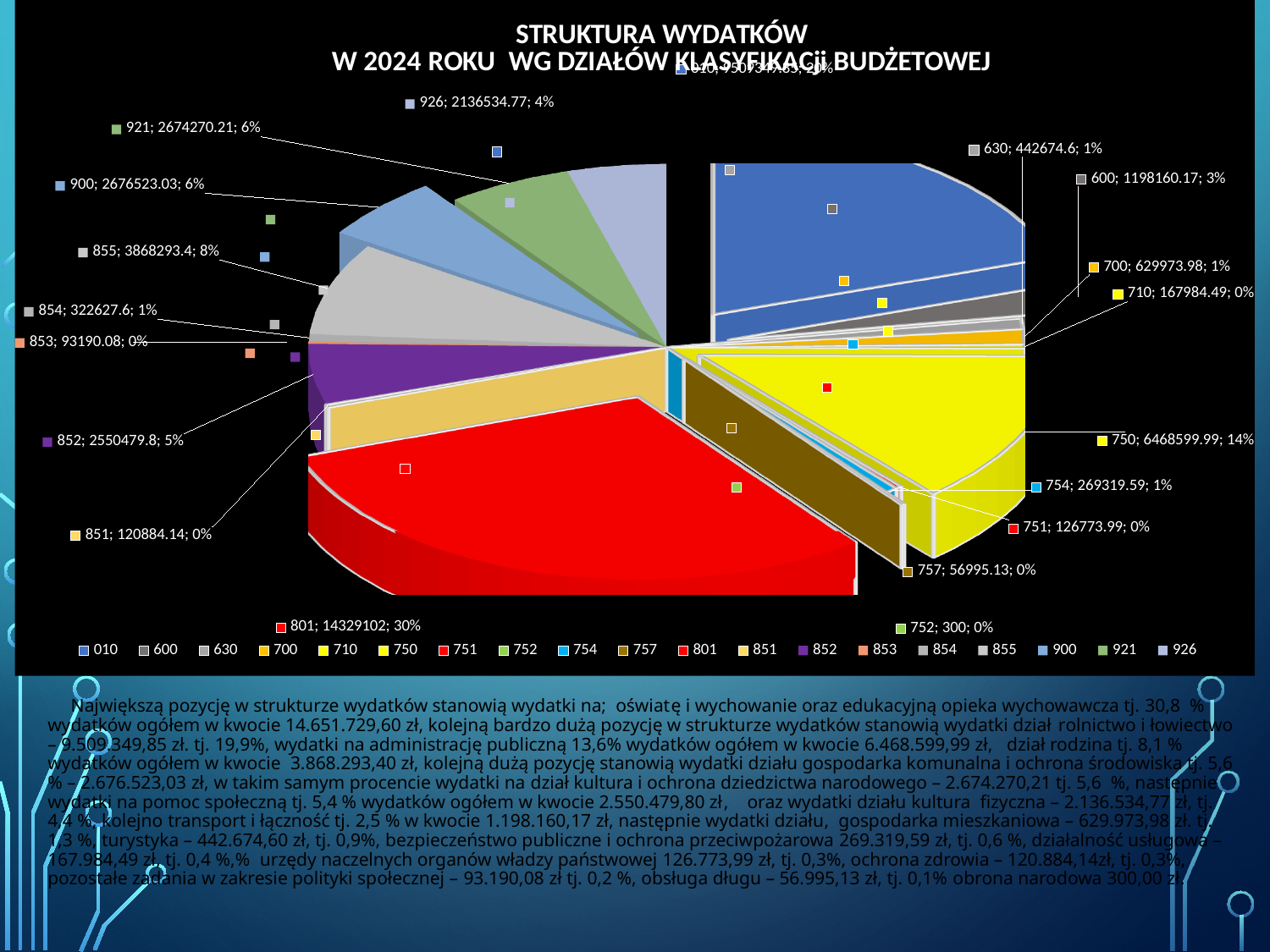
What is the value shown for dział 926? 2136534.77 What is the difference between the values for dział 900 and dział 921? 2252.82 What is the value shown for dział 801 in the pie chart? 14329102 How many categories (dział codes) does the legend of the pie chart list? 19 Which has the larger value, dział 855 or dział 852? 855 What share of the pie does dział 801 represent? 30% Which dział has the smallest value in the pie chart? 752 What is the value shown for dział 750? 6468599.99 Which dział has the largest slice of the pie? 801 What kind of chart is shown on the slide? pie chart What is the difference between the values for dział 754 and dział 751? 142545.60 What share of the pie does dział 855 represent? 8%